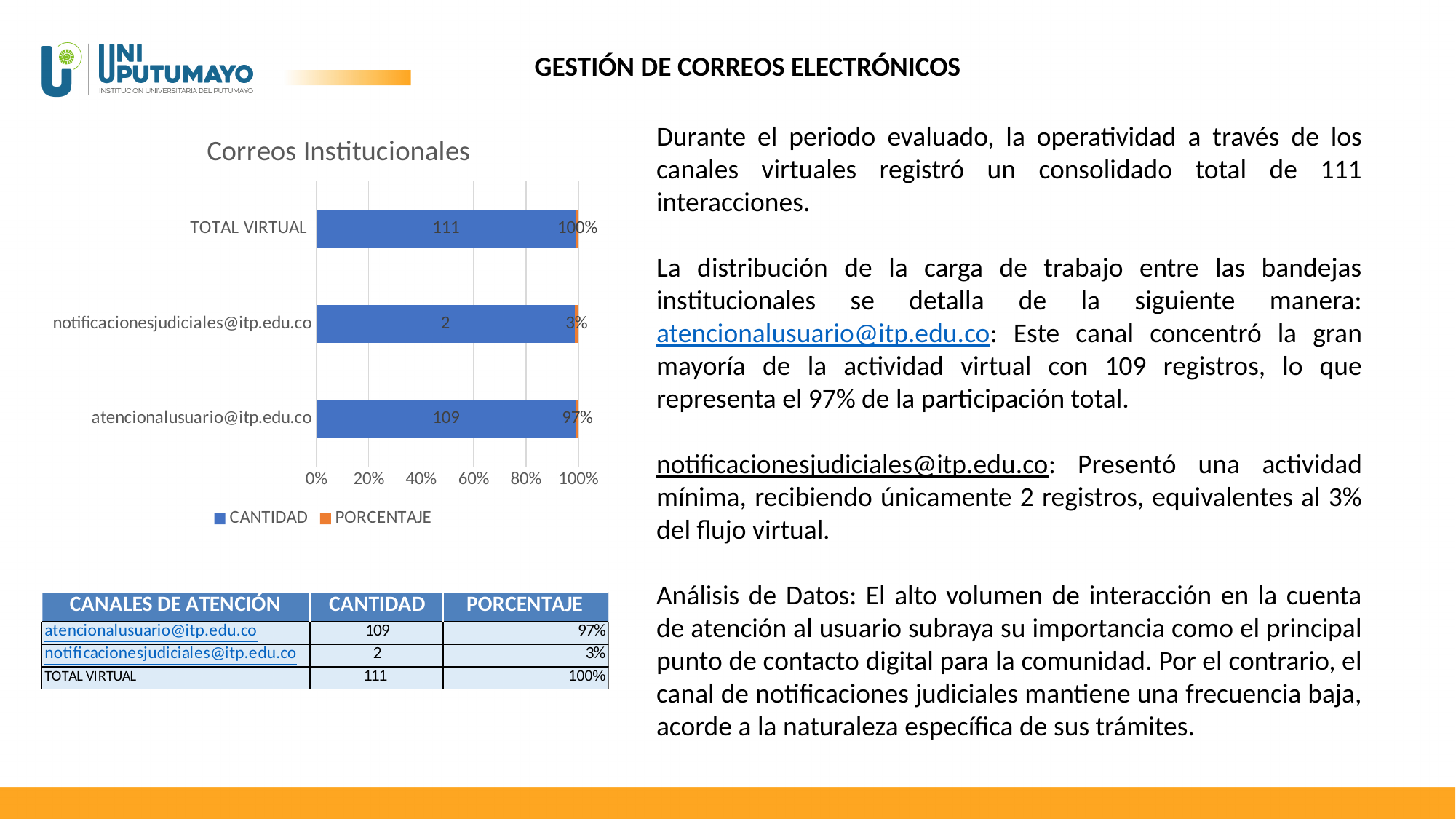
What is the CANTIDAD value for notificacionesjudiciales@itp.edu.co? 2 What is the PORCENTAJE value for atencionalusuario@itp.edu.co? 97% Which email channel has the lowest CANTIDAD value? notificacionesjudiciales@itp.edu.co What is the PORCENTAJE value for notificacionesjudiciales@itp.edu.co? 3% What is the CANTIDAD value for TOTAL VIRTUAL? 111 How many series does the chart legend list? 2 How many categories are shown on the chart? 3 What is the CANTIDAD value for atencionalusuario@itp.edu.co? 109 What are the two series listed in the chart legend? CANTIDAD and PORCENTAJE What is the difference in CANTIDAD between atencionalusuario@itp.edu.co and notificacionesjudiciales@itp.edu.co? 107 What type of chart is shown on the slide? bar chart What is the title of the chart? Correos Institucionales